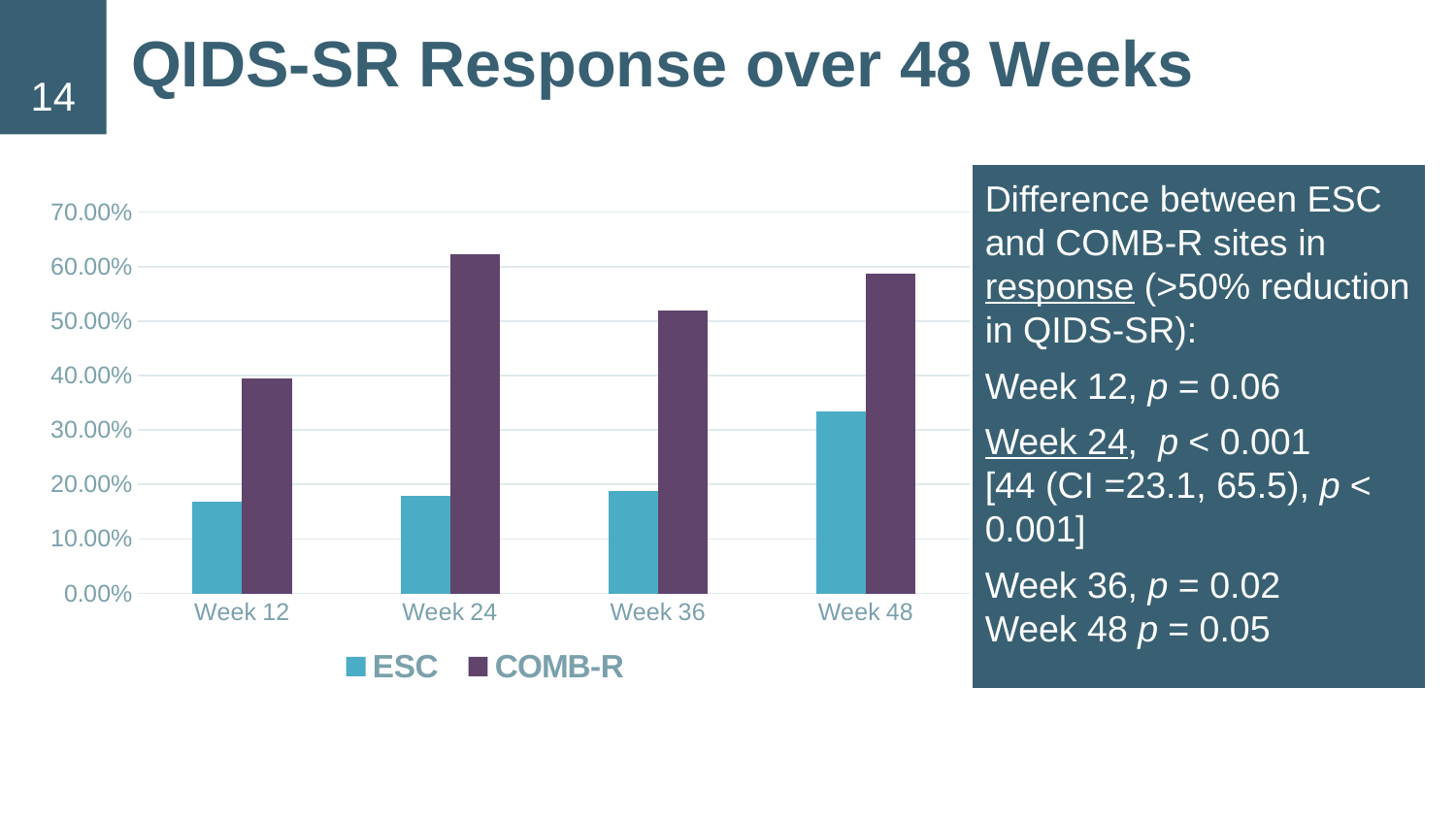
What is the title of the chart on the slide? QIDS-SR Response over 48 Weeks At Week 24, which group has the higher response rate, ESC or COMB-R? COMB-R How many time points (categories) are shown on the x axis? 4 What kind of chart is shown on the slide? Bar chart Does the ESC response rate rise or fall from Week 12 to Week 48? Rise At which week is the COMB-R response rate lowest? Week 12 Is the COMB-R value at Week 24 greater or less than 60.00%? greater At which week is the COMB-R response rate highest? Week 24 How many series does the legend list? 2 At which week is the ESC response rate highest? Week 48 Is the COMB-R value at Week 36 greater or less than 50.00%? greater Is the ESC value at Week 12 greater or less than 20.00%? less